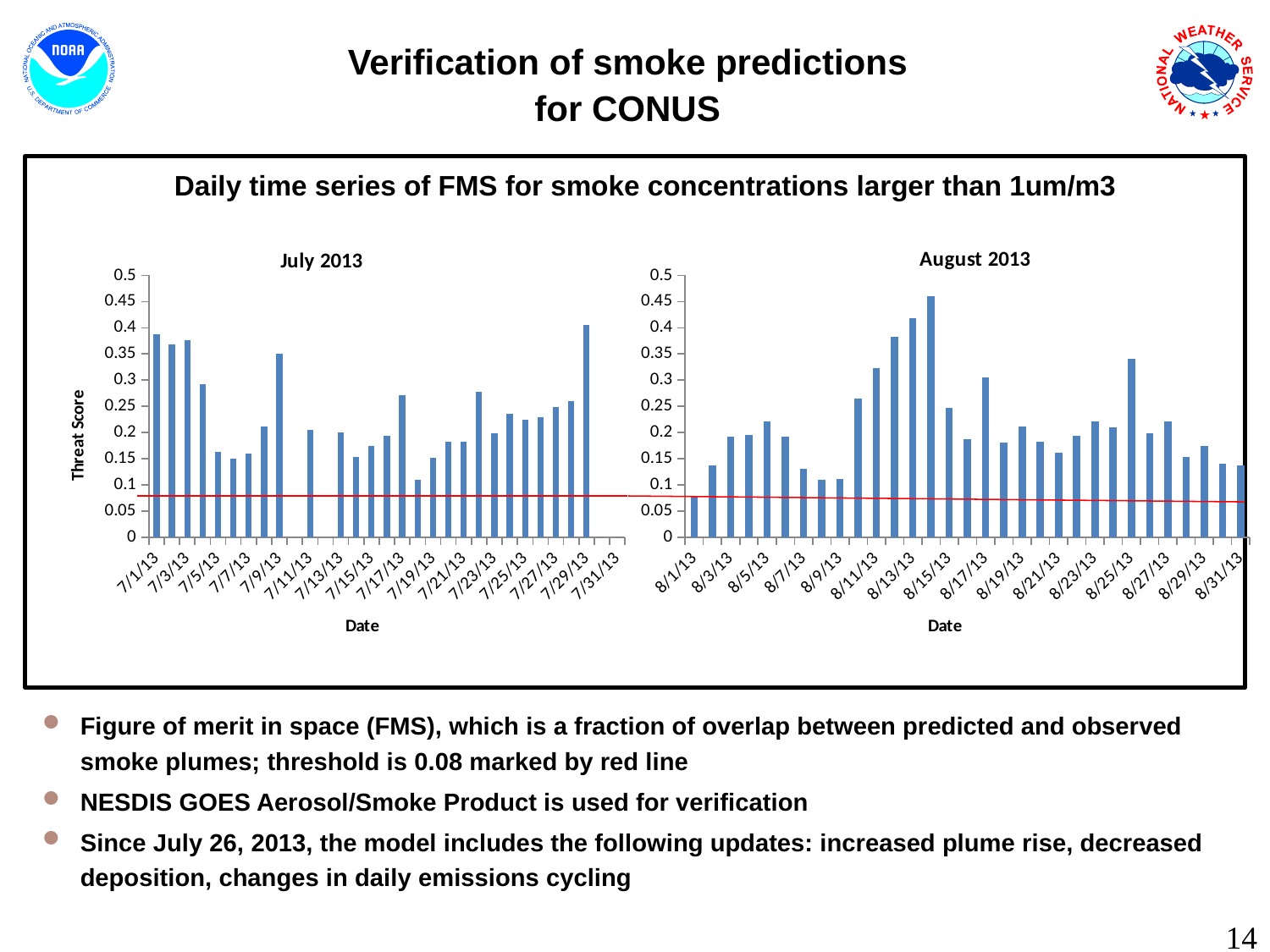
What kind of chart is the August 2013 chart? bar chart In the August 2013 chart, is the tallest bar greater or less than 0.4? greater What threshold value does the red line on the charts mark? 0.08 What kind of chart is the July 2013 chart? bar chart In the July 2013 chart, is the value for 7/5/13 greater or less than 0.2? less In the August 2013 chart, do the bars rise or fall from 8/9/13 to 8/13/13? rise What is the y-axis label of the July 2013 chart? Threat Score In the August 2013 chart, is the value for 8/1/13 greater or less than 0.1? less Which chart contains the highest threat score bar, July 2013 or August 2013? August 2013 Which is larger, the value for 7/1/13 in the July 2013 chart or the value for 8/1/13 in the August 2013 chart? 7/1/13